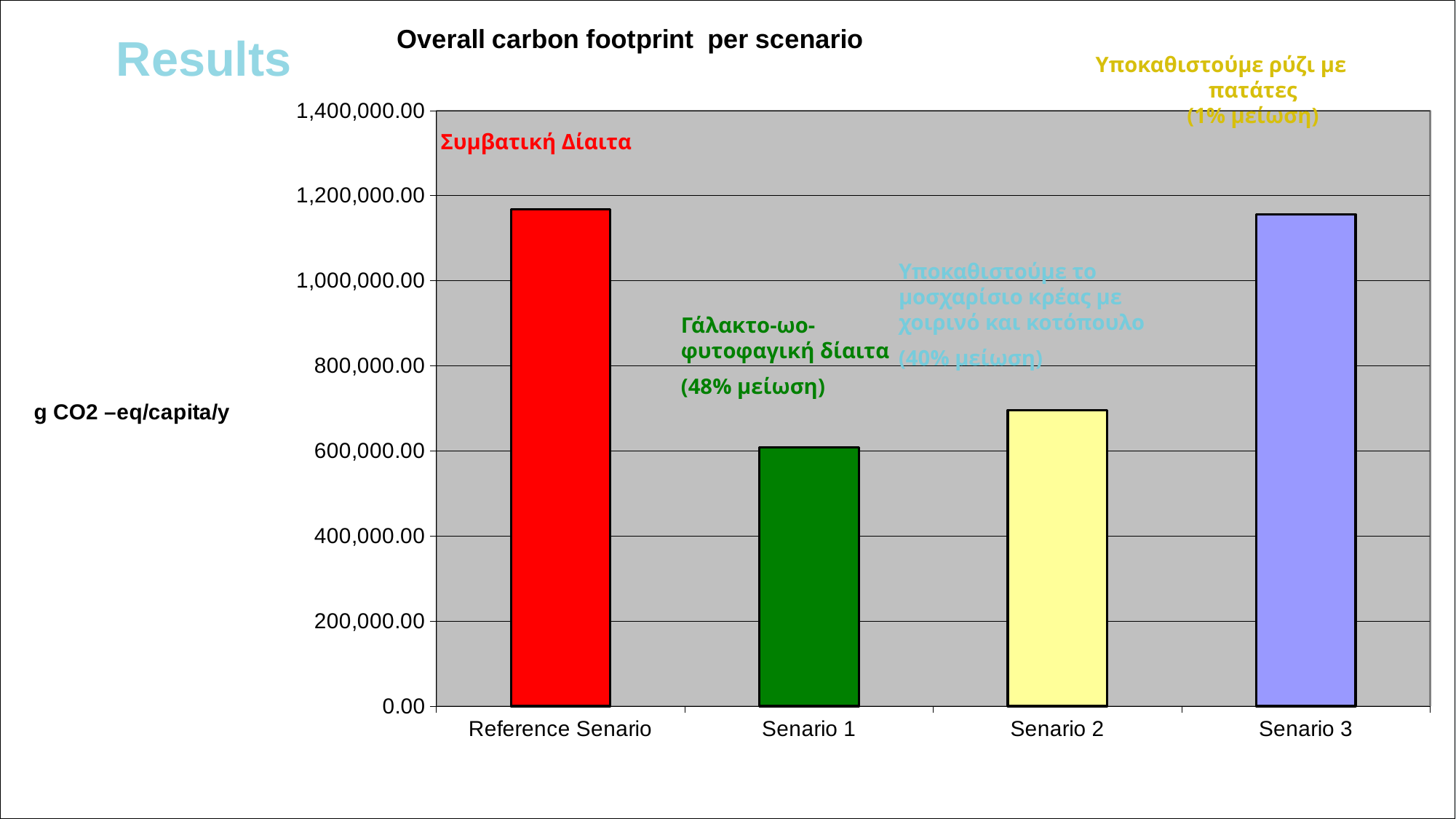
What type of chart is shown on the slide? bar chart What is the title of the chart? Overall carbon footprint per scenario Which has the larger carbon footprint, Reference Senario or Senario 2? Reference Senario Is the value for Senario 3 greater or less than 1,200,000.00? less Is the value for Reference Senario greater or less than 1,000,000.00? greater How many scenarios (bars) are plotted in the chart? 4 Is the value for Senario 1 greater or less than 800,000.00? less Which scenario has the lowest overall carbon footprint? Senario 1 Which has the larger carbon footprint, Senario 1 or Senario 2? Senario 2 What unit is given for the vertical axis of the chart? g CO2 –eq/capita/y